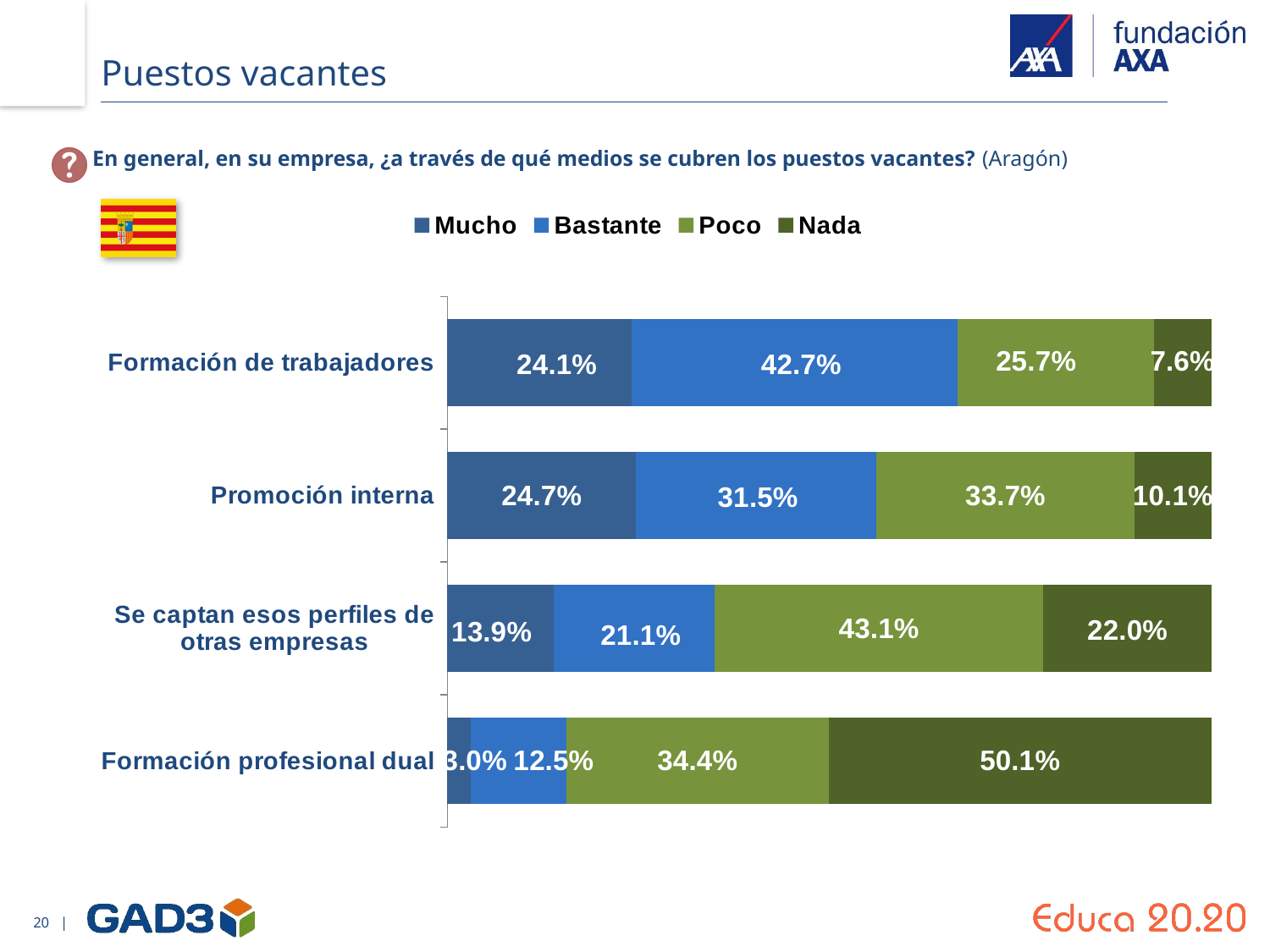
How many categories are plotted on the chart? 4 What is the 'Poco' value for 'Promoción interna'? 33.7% Which category has the highest 'Nada' value? Formación profesional dual What is the 'Nada' value for 'Formación profesional dual'? 50.1% Which legend entry is shown in the darkest green colour? Nada Which is larger: the 'Bastante' value for 'Promoción interna' or the 'Bastante' value for 'Se captan esos perfiles de otras empresas'? Promoción interna What is the 'Mucho' value for 'Se captan esos perfiles de otras empresas'? 13.9% Which category has the lowest 'Nada' value? Formación de trabajadores What is the difference between the 'Poco' values for 'Se captan esos perfiles de otras empresas' and 'Formación de trabajadores'? 17.4% What kind of chart is shown on the slide? Stacked bar chart How many series does the legend list? 4 What is the 'Bastante' value for 'Formación de trabajadores'? 42.7%